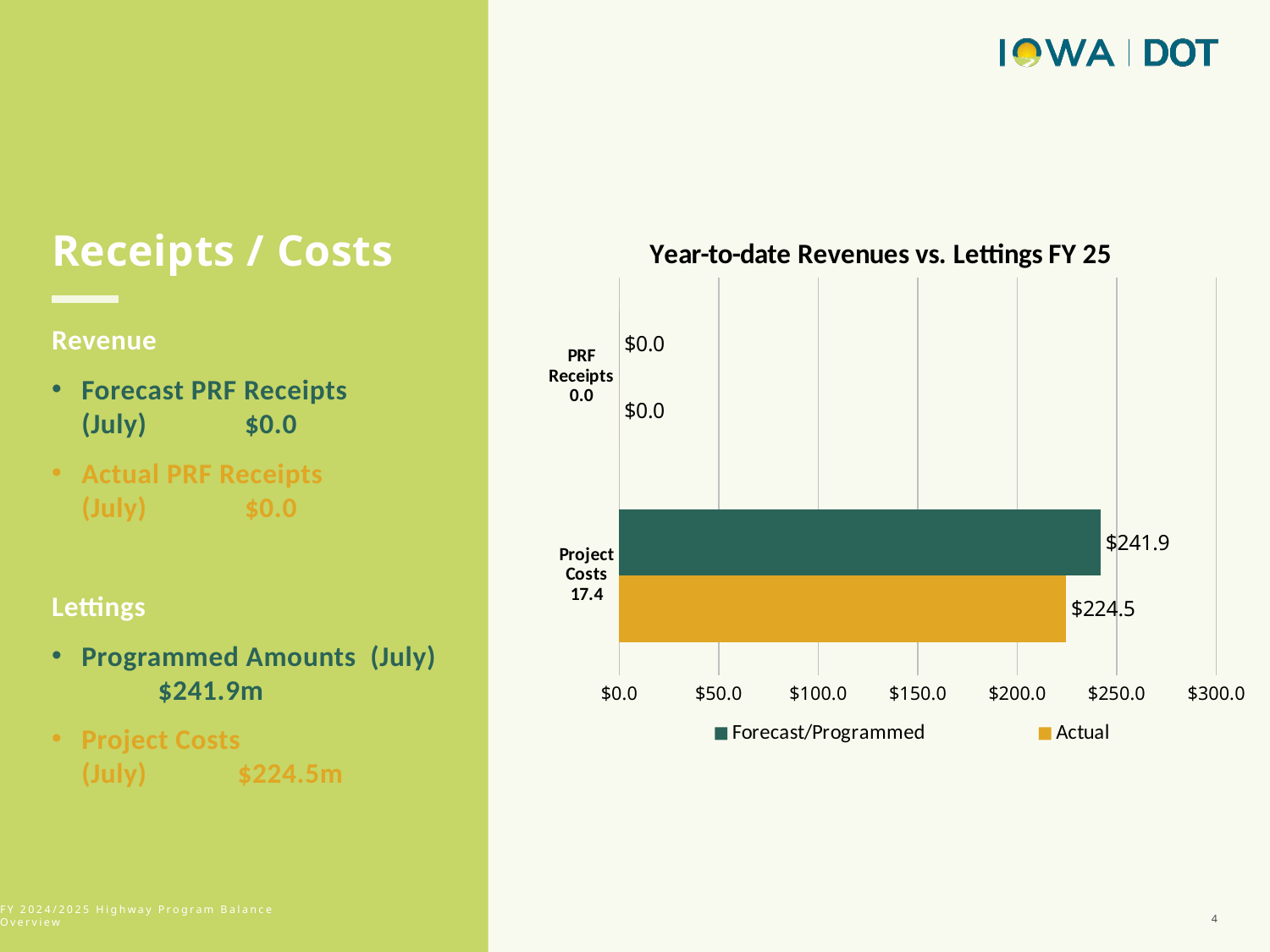
What type of chart is shown on the slide? bar chart What is the Forecast/Programmed value for PRF Receipts? $0.0 What is the Actual value for Project Costs? $224.5 What is the Actual value for PRF Receipts? $0.0 What are the two series named in the legend? Forecast/Programmed and Actual What is the Forecast/Programmed value for Project Costs? $241.9 What is the difference between the Forecast/Programmed and Actual values for Project Costs? $17.4 For Project Costs, which is larger: the Forecast/Programmed value or the Actual value? Forecast/Programmed Is the Actual value for Project Costs greater or less than $200.0? greater How many series does the chart legend list? 2 How many categories are shown on the chart? 2 What is the title of the chart? Year-to-date Revenues vs. Lettings FY 25